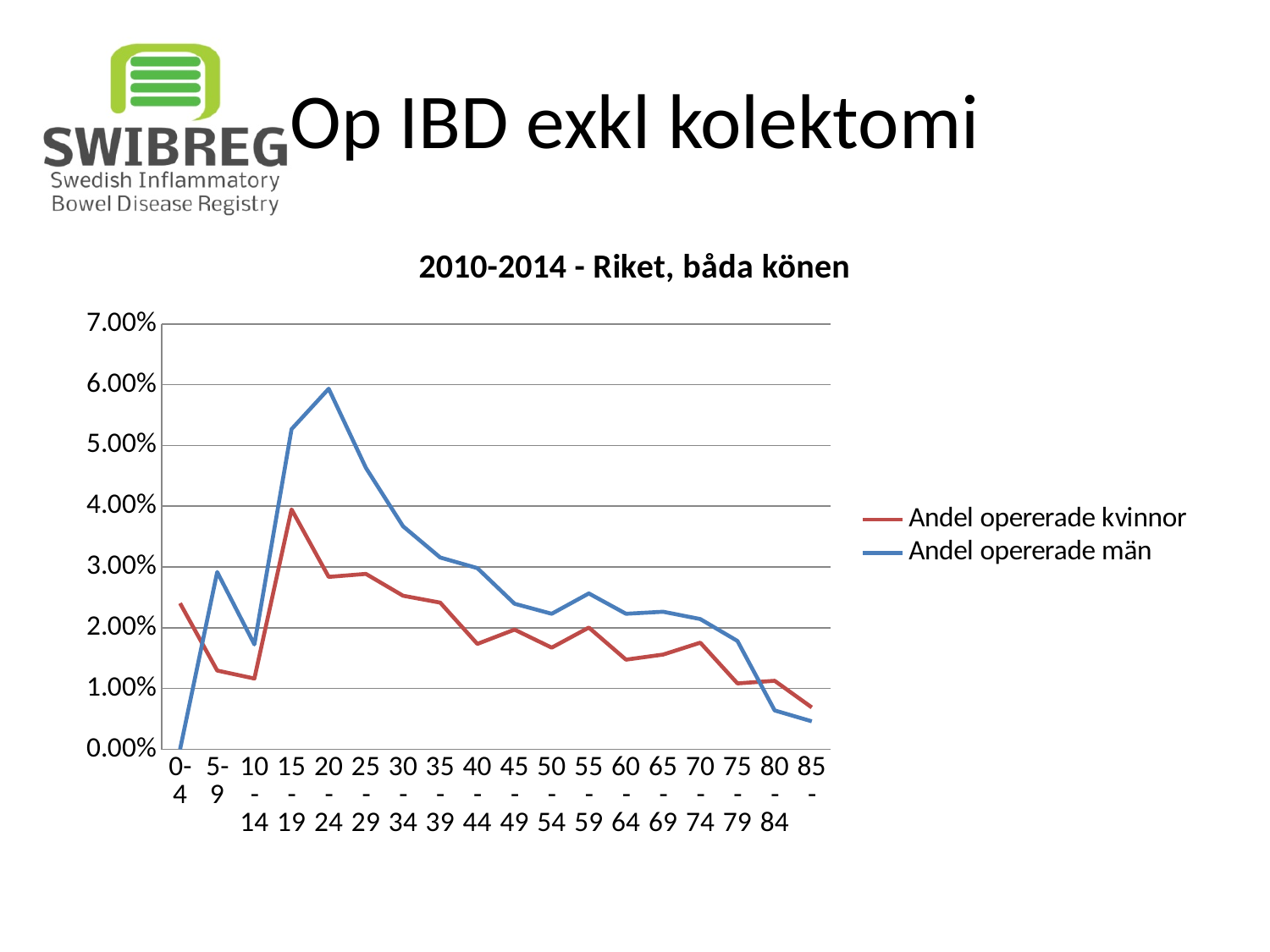
In which age group is the 'Andel opererade kvinnor' value lowest? 85- How many age groups are shown along the x axis? 18 Is the value for 'Andel opererade kvinnor' in the 15-19 age group greater or less than 3.00%? greater In which age group does the 'Andel opererade kvinnor' line reach its highest value? 15-19 What kind of chart is shown on the slide? line chart Does the 'Andel opererade män' line generally rise or fall from the 20-24 age group to the 85- age group? fall Is the value for 'Andel opererade män' in the 20-24 age group greater or less than 5.00%? greater What is the title of the chart? 2010-2014 - Riket, båda könen In the 0-4 age group, which series has the higher value, 'Andel opererade kvinnor' or 'Andel opererade män'? Andel opererade kvinnor In which age group does the 'Andel opererade män' line reach its highest value? 20-24 How many series does the legend list? 2 In the 20-24 age group, which series has the higher value, 'Andel opererade kvinnor' or 'Andel opererade män'? Andel opererade män